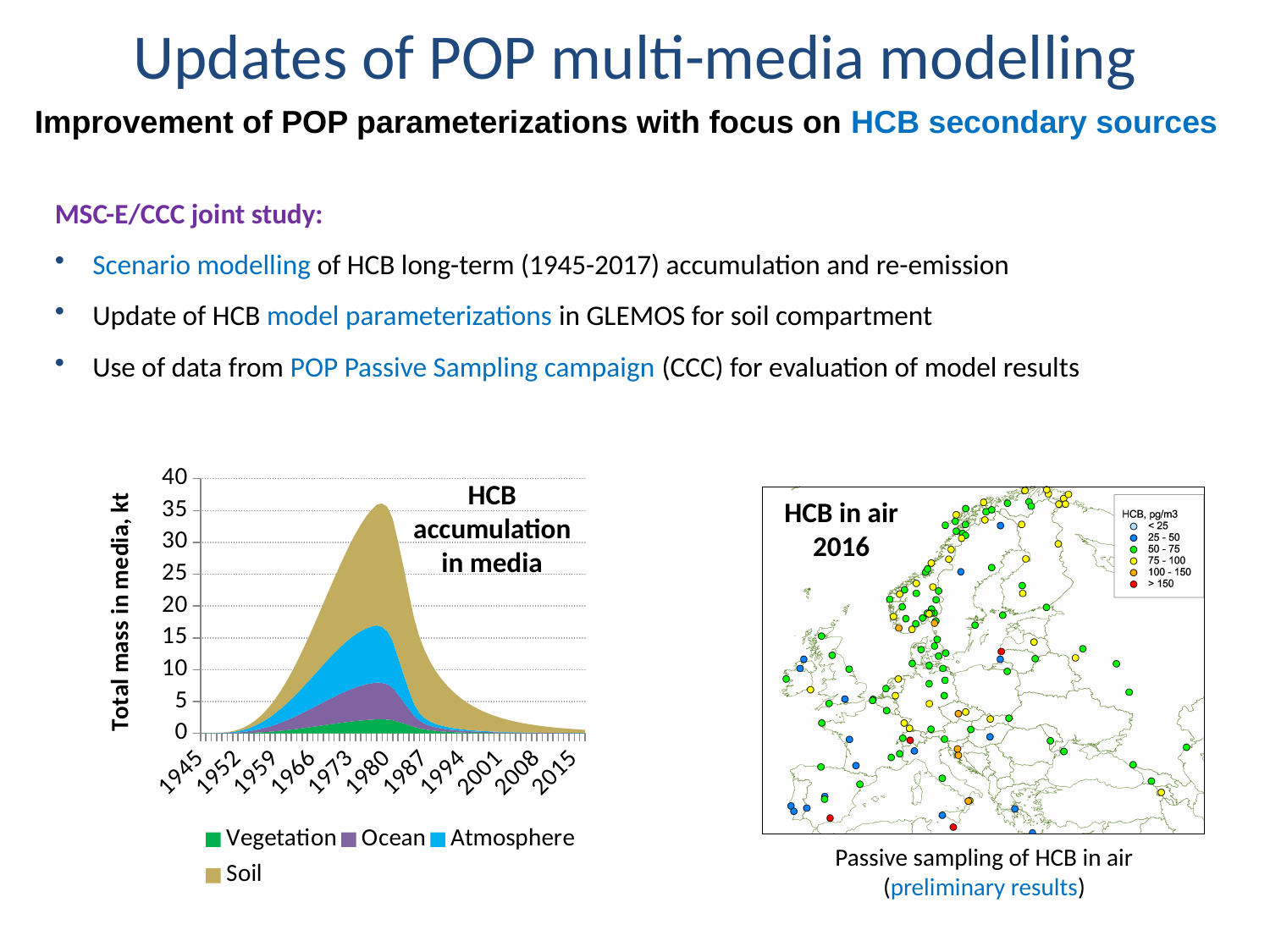
In the 'HCB accumulation in media' chart, does the total mass in media rise or fall between 1952 and 1980? rise In the 'HCB accumulation in media' chart, does the total mass in media rise or fall between 1980 and 2015? fall How many series does the legend of the 'HCB accumulation in media' chart list? 4 In the 'HCB accumulation in media' chart, which is larger around 1980: the mass in Soil or the mass in Atmosphere? Soil In the 'HCB accumulation in media' chart, is the total mass in media around 1980 greater or less than 30 kt? greater What is the y-axis label of the 'HCB accumulation in media' chart? Total mass in media, kt In the 'HCB accumulation in media' chart, which series accounts for the largest share of the total mass around 1980? Soil Which series are listed in the legend of the 'HCB accumulation in media' chart? Vegetation, Ocean, Atmosphere, Soil What kind of chart is the 'HCB accumulation in media' chart? stacked area chart In the 'HCB accumulation in media' chart, is the total mass in media in 1945 greater or less than 5 kt? less In the 'HCB accumulation in media' chart, which series accounts for the smallest share of the total mass around 1980? Vegetation In the 'HCB accumulation in media' chart, is the total mass in media in 2015 greater or less than 5 kt? less